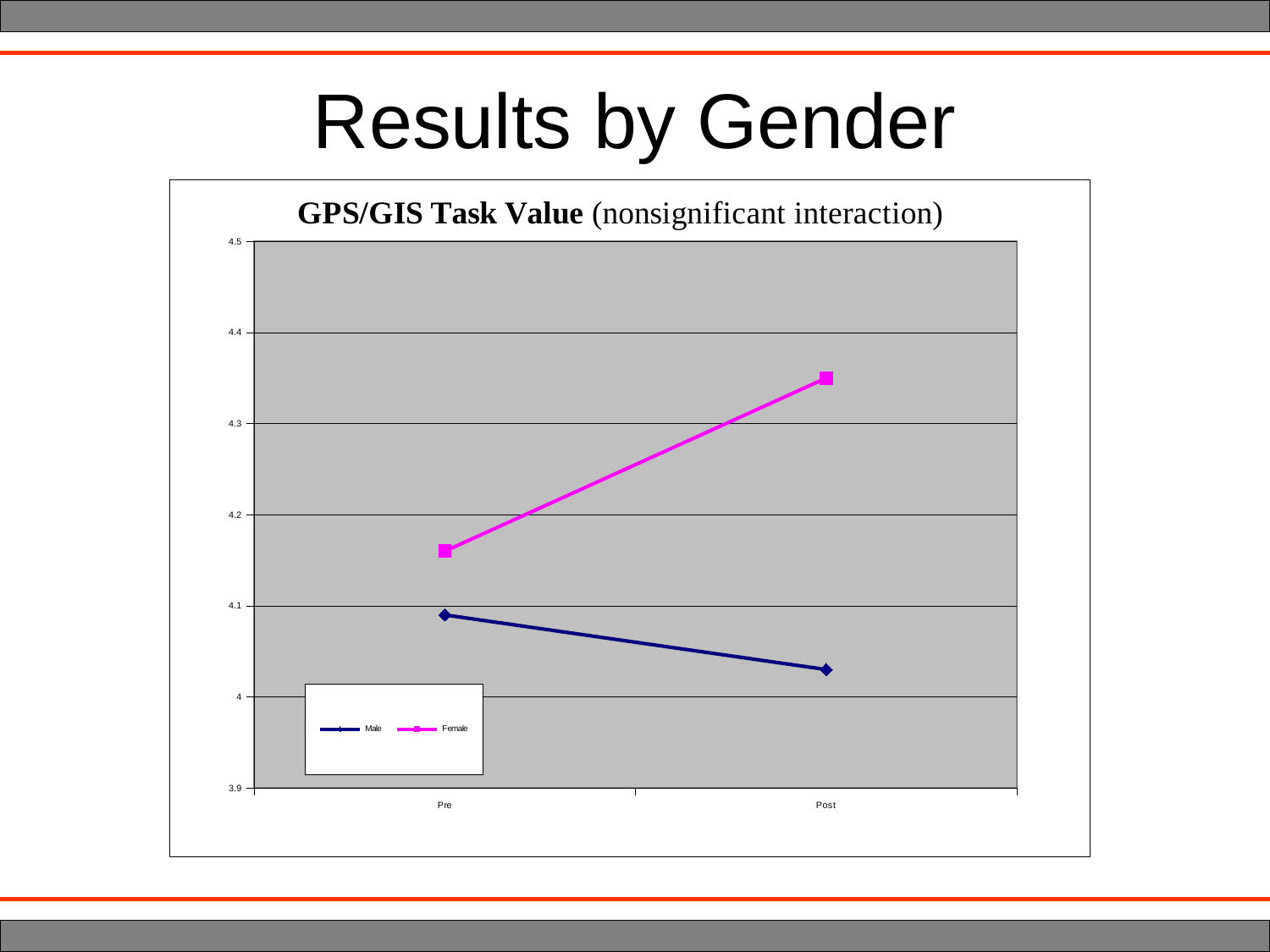
How many series does the legend list? 2 At Post, which series has the larger value, Male or Female? Female Is the Male value at Post greater or less than 4.1? less How many categories are shown on the x axis? 2 What is the title of the chart? GPS/GIS Task Value (nonsignificant interaction) Does the Male series rise or fall from Pre to Post? fall Does the Female series rise or fall from Pre to Post? rise Which series reaches the highest value on the chart? Female What kind of chart is shown on the slide? line chart Is the Female value at Pre greater or less than 4.1? greater Is the Female value at Post greater or less than 4.4? less